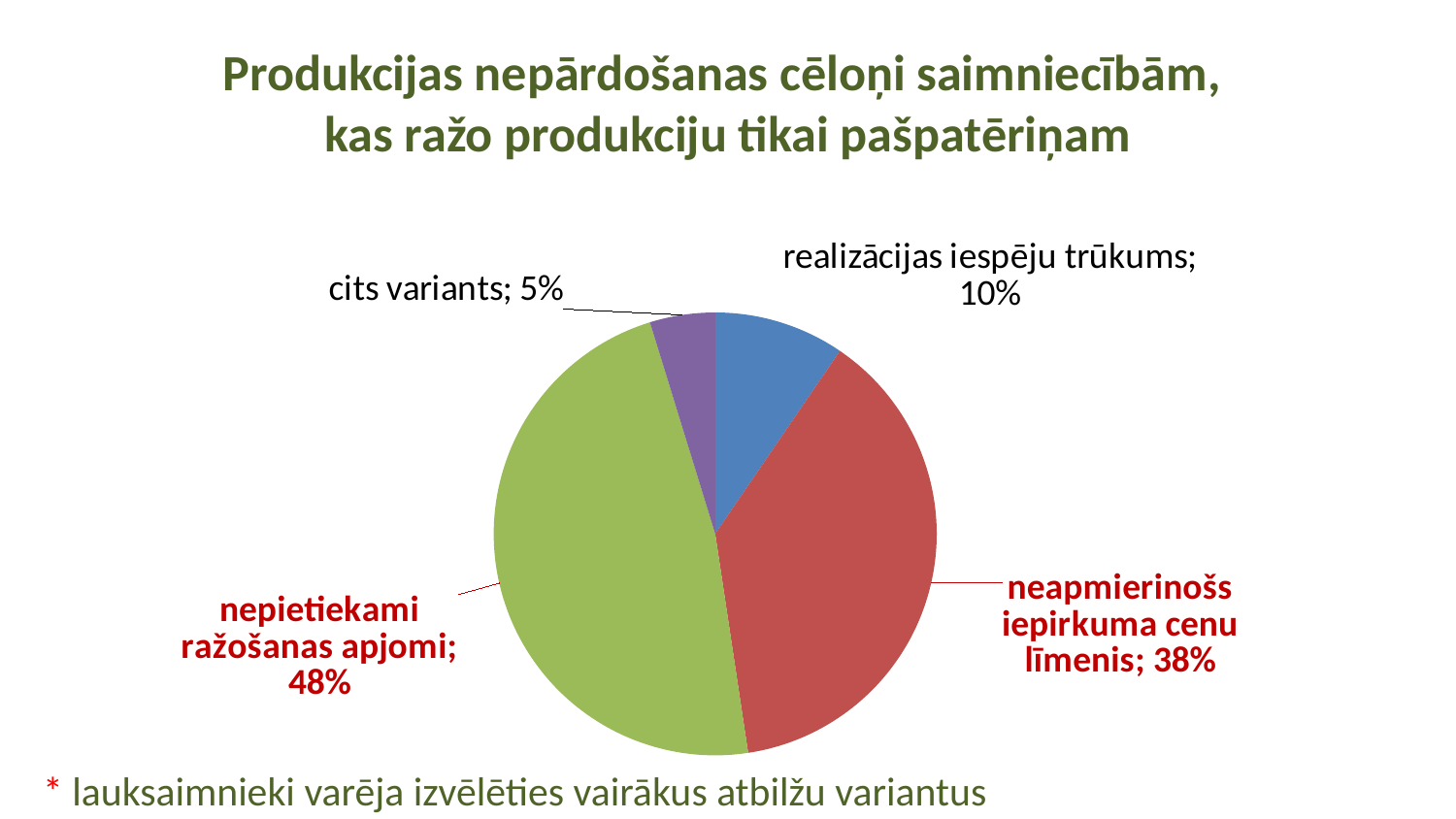
What is the difference between the values for 'nepietiekami ražošanas apjomi' and 'neapmierinošs iepirkuma cenu līmenis'? 10% What share of the pie does 'nepietiekami ražošanas apjomi' represent? 48% What is the difference between the values for 'realizācijas iespēju trūkums' and 'cits variants'? 5% What is the value shown for 'cits variants'? 5% What kind of chart is shown on the slide? pie chart Which is larger: the value for 'realizācijas iespēju trūkums' or the value for 'cits variants'? realizācijas iespēju trūkums How many categories are shown in the pie chart? 4 Which category has the smallest slice of the pie? cits variants What is the value shown for 'neapmierinošs iepirkuma cenu līmenis'? 38% What colour is the slice for 'neapmierinošs iepirkuma cenu līmenis'? red Which category has the largest slice of the pie? nepietiekami ražošanas apjomi What is the value shown for 'realizācijas iespēju trūkums'? 10%